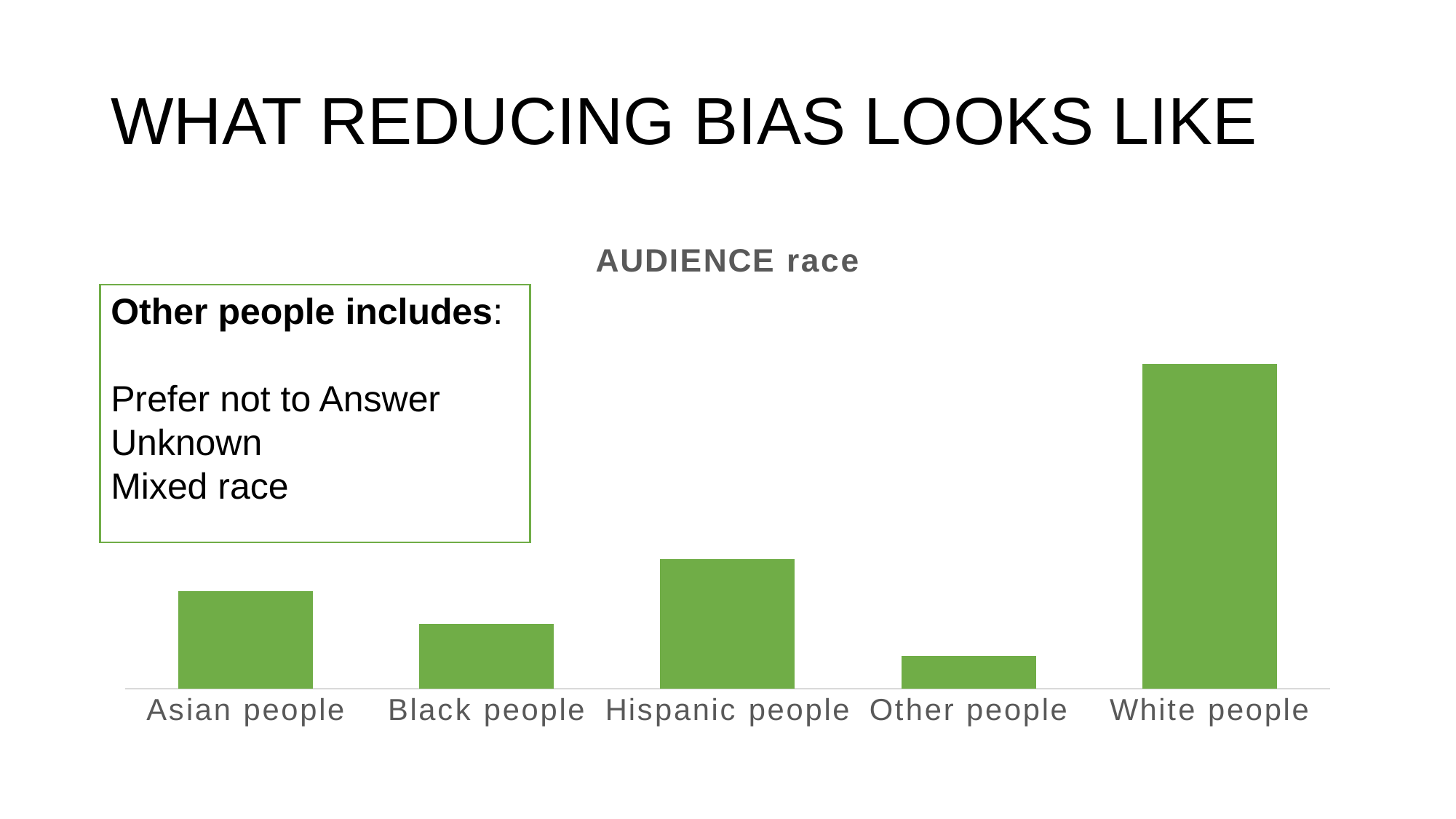
What is the title of the chart? AUDIENCE race How many categories are shown on the x axis of the chart? 5 Which is larger, the bar for Asian people or the bar for Black people? Asian people What kind of chart is shown on the slide? Bar chart Which category has the second-highest bar in the chart? Hispanic people What colour are the bars in the chart? Green Which is larger, the bar for White people or the bar for Hispanic people? White people Which category has the lowest bar in the chart? Other people Which is larger, the bar for Black people or the bar for Other people? Black people Which category has the highest bar in the chart? White people